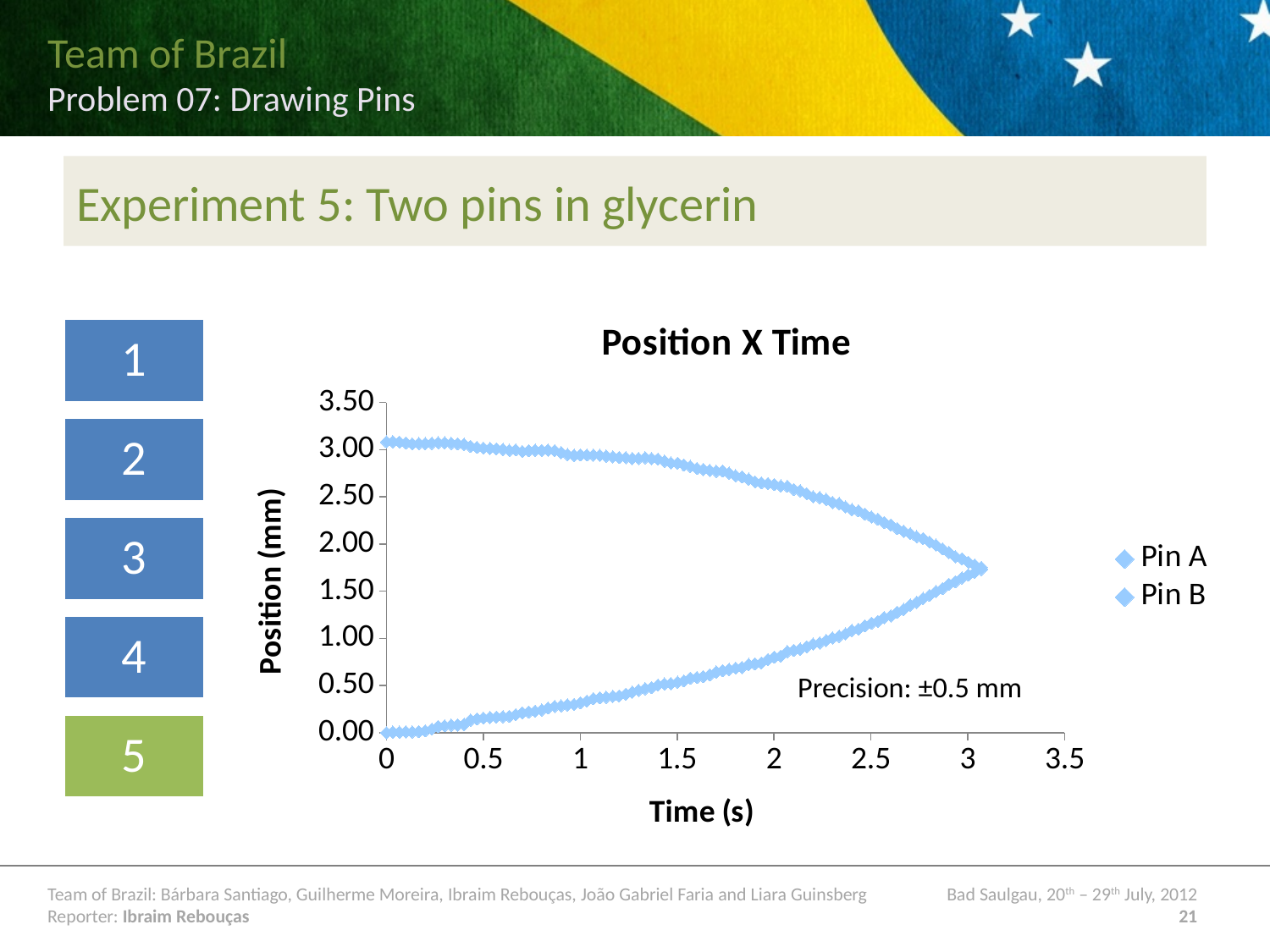
Is the position of the lower curve at time 2 s greater or less than 1.00 mm? less What are the two series named in the chart legend? Pin A and Pin B What kind of chart is shown on the slide? scatter chart Is the position of the upper curve at time 3 s greater or less than 2.50 mm? less How many series does the legend of the chart list? 2 Is the position of the upper curve at time 1 s greater or less than 2.50 mm? greater As time increases, do the two curves in the chart move closer together or further apart? closer together Does the upper curve in the chart rise or fall as time increases? fall Does the lower curve in the chart rise or fall as time increases? rise What is the title of the chart? Position X Time